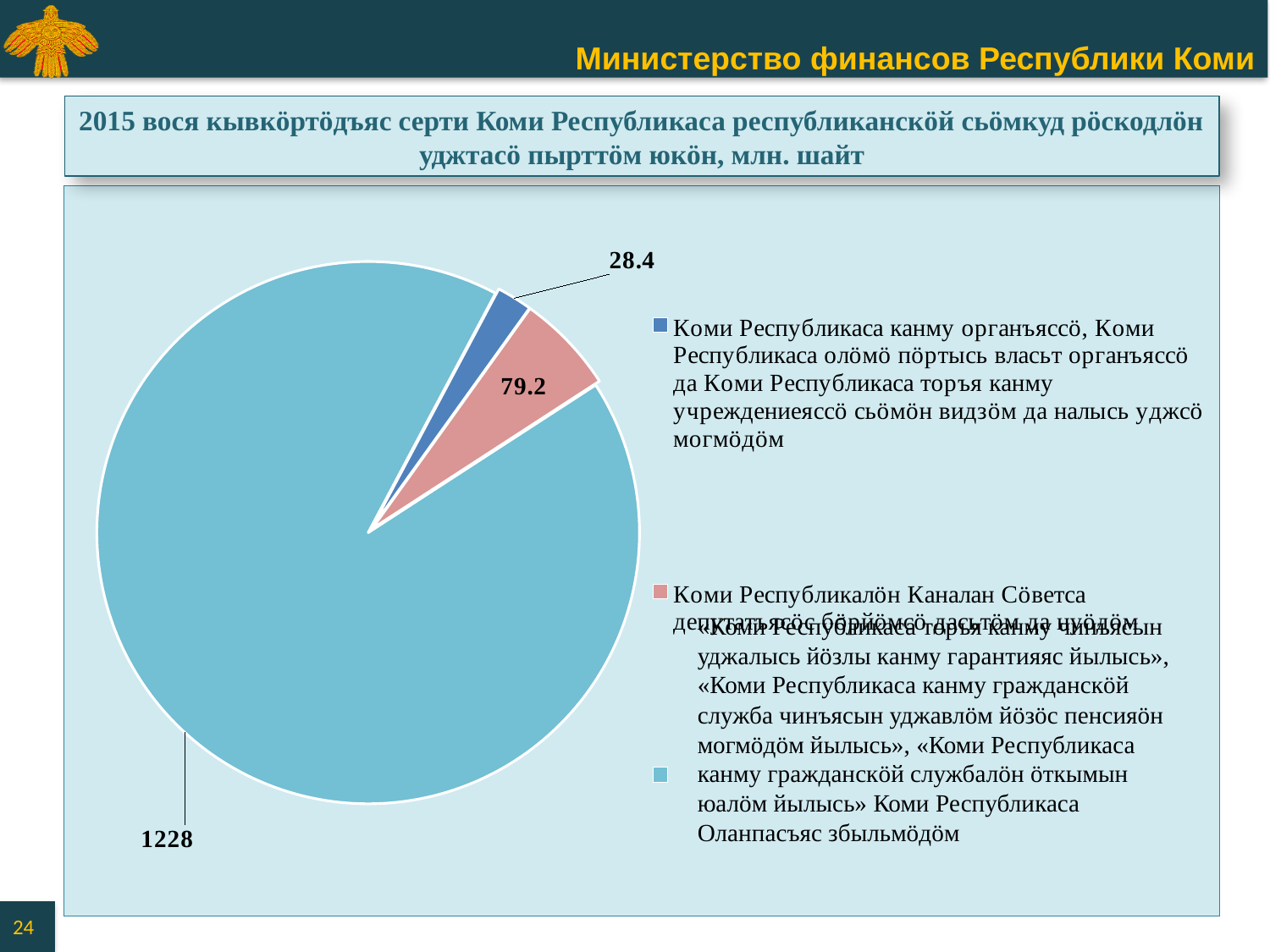
What is the value of the pink slice of the pie chart? 79.2 What kind of chart is shown on the slide? pie chart What is the difference between the values of the pink slice (79.2) and the dark blue slice (28.4)? 50.8 What is the value of the largest slice of the pie chart? 1228 What is the value of the dark blue slice, the one for the legend entry beginning 'Коми Республикаса канму органъяссö'? 28.4 What is the difference between the largest slice (1228) and the pink slice (79.2)? 1148.8 In what units are the values of the pie chart given, according to the slide title? млн. шайт How many slices does the pie chart have? 3 What is the value of the smallest slice of the pie chart? 28.4 How many entries does the legend of the pie chart list? 3 Which slice is larger, the pink one or the dark blue one? the pink one (79.2) What is the total of all three slices of the pie chart? 1335.6